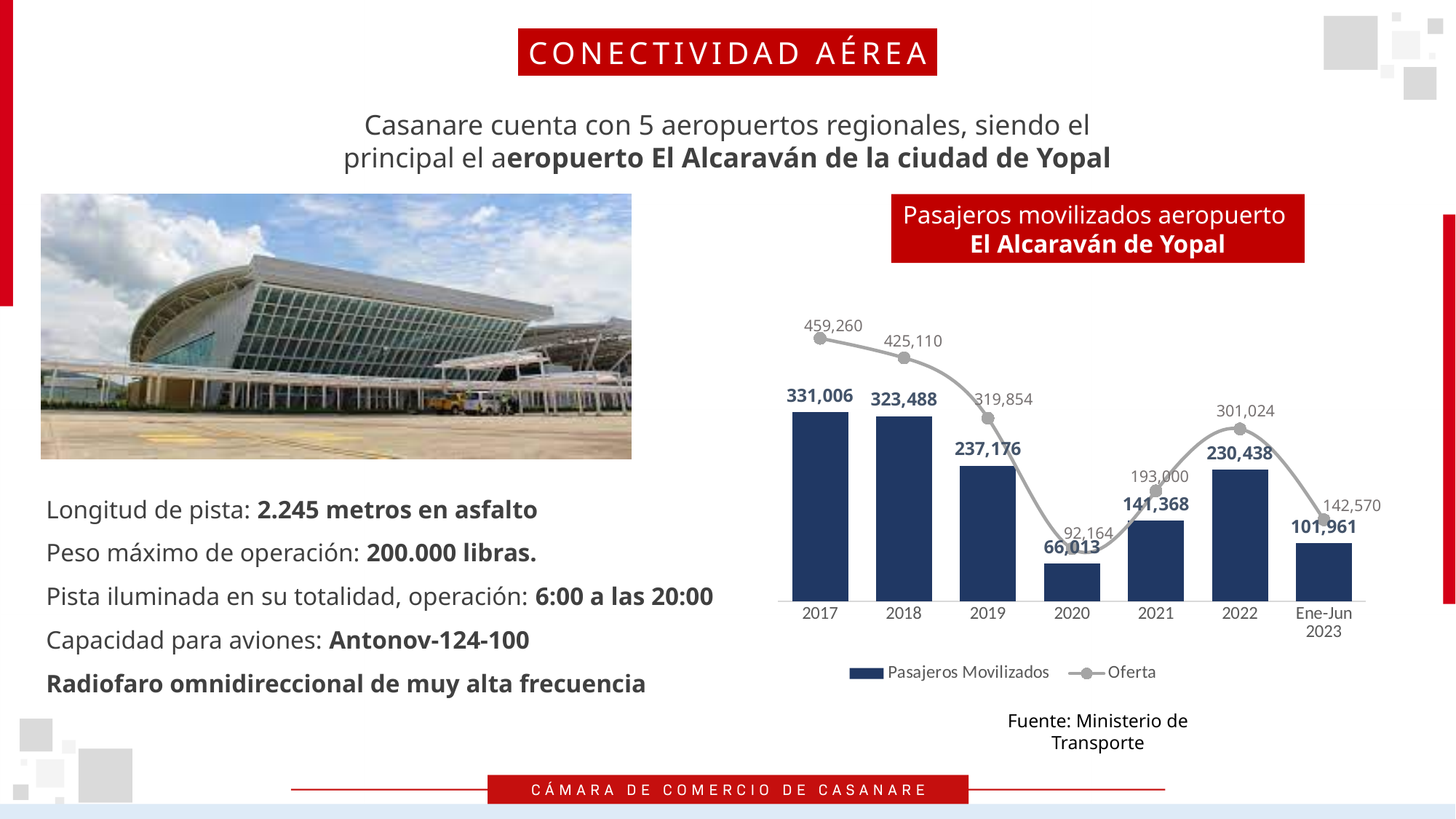
How many series does the legend list? 2 How many periods are shown on the x axis of the chart? 7 What kind of chart is shown on the slide? Combined bar and line chart What is the difference between Pasajeros Movilizados in 2017 and 2018? 7,518 Which year has the highest Oferta value? 2017 What is the Oferta value for 2018? 425,110 Which is larger, Pasajeros Movilizados in 2019 or in 2022? 2019 Do the Pasajeros Movilizados values rise or fall from 2017 to 2020? Fall What is the value of Pasajeros Movilizados for Ene-Jun 2023? 101,961 Which year has the lowest value of Pasajeros Movilizados? 2020 What is the value of Pasajeros Movilizados for 2017? 331,006 What is the difference between Oferta and Pasajeros Movilizados in 2022? 70,586